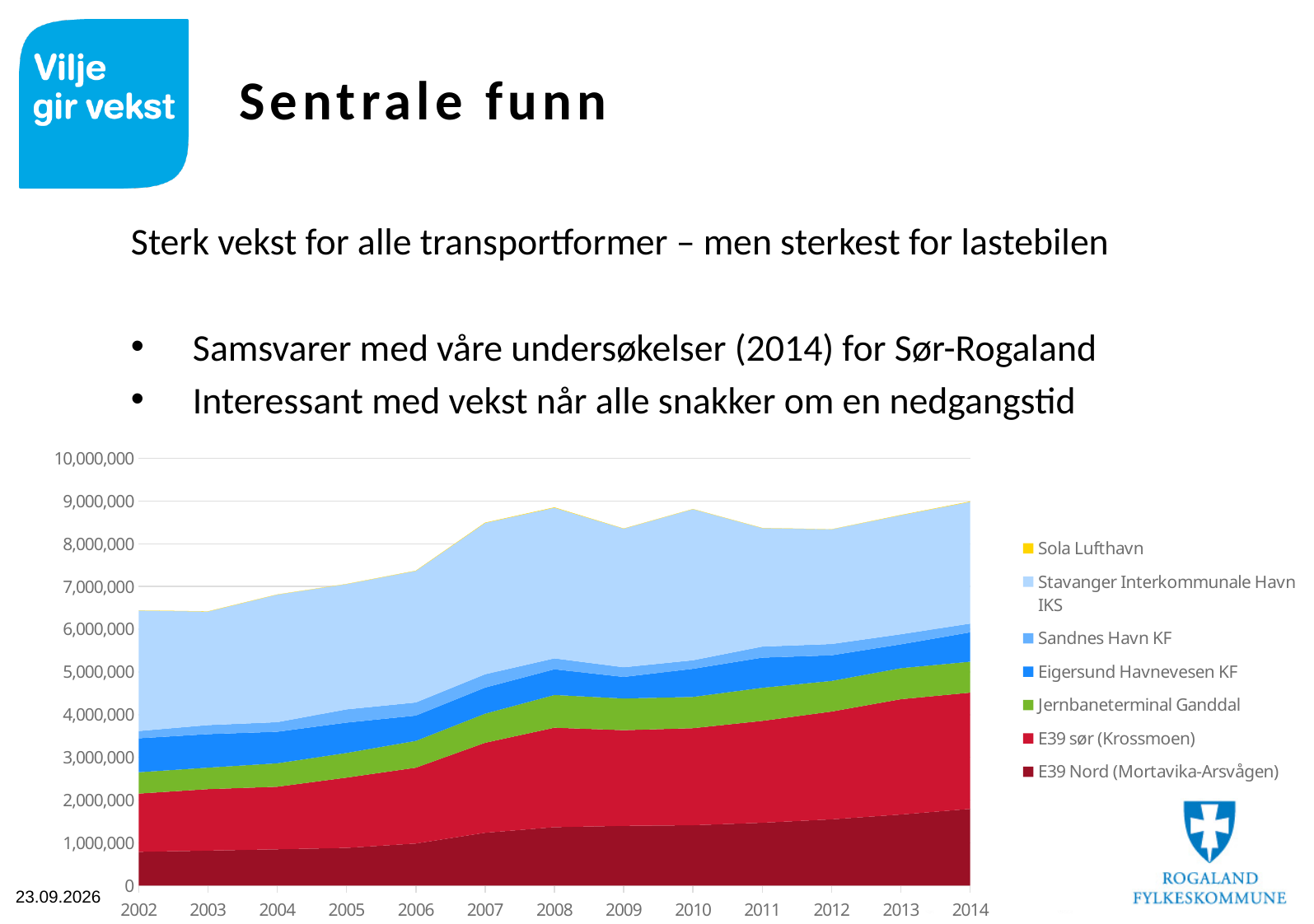
What is the first year shown on the x axis of the chart? 2002 What is the last year shown on the x axis of the chart? 2014 What kind of chart is shown on the slide? Stacked area chart Which is larger, the total stacked value in 2002 or in 2014? 2014 How many series does the chart legend list? 7 Is the value for E39 Nord (Mortavika-Arsvågen) in 2014 greater or less than 1,000,000? greater Is the total stacked value for 2002 greater or less than 7,000,000? less Does the E39 Nord (Mortavika-Arsvågen) series rise or fall from 2002 to 2014? Rise In 2014, which series has the larger value: E39 sør (Krossmoen) or Jernbaneterminal Ganddal? E39 sør (Krossmoen) How many years are shown along the x axis of the chart? 13 Is the total stacked value for 2009 greater or less than 9,000,000? less Does the total stacked value in the chart generally rise or fall from 2002 to 2014? Rise